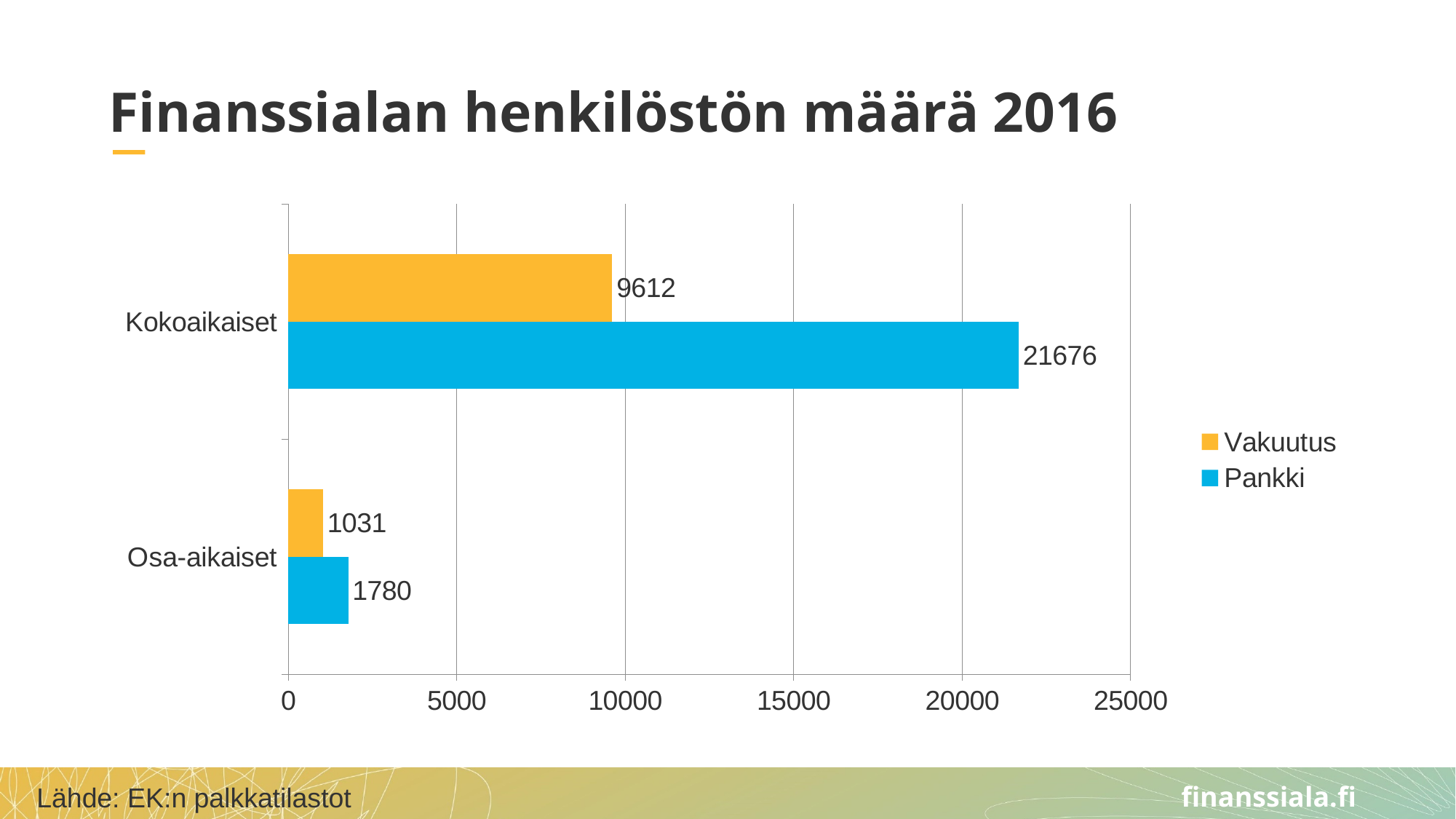
What is the Pankki value for Osa-aikaiset? 1780 What is the difference between the Pankki and Vakuutus values for Kokoaikaiset? 12064 What is the Vakuutus value for Kokoaikaiset? 9612 What is the Pankki value for Kokoaikaiset? 21676 Which bar has the highest value on the chart? Pankki, Kokoaikaiset How many series does the legend list? 2 What type of chart is shown on the slide? Bar chart How many categories are shown on the chart? 2 What is the Vakuutus value for Osa-aikaiset? 1031 What is the difference between the Pankki and Vakuutus values for Osa-aikaiset? 749 Which bar has the lowest value on the chart? Vakuutus, Osa-aikaiset Which is larger for Osa-aikaiset, Vakuutus or Pankki? Pankki